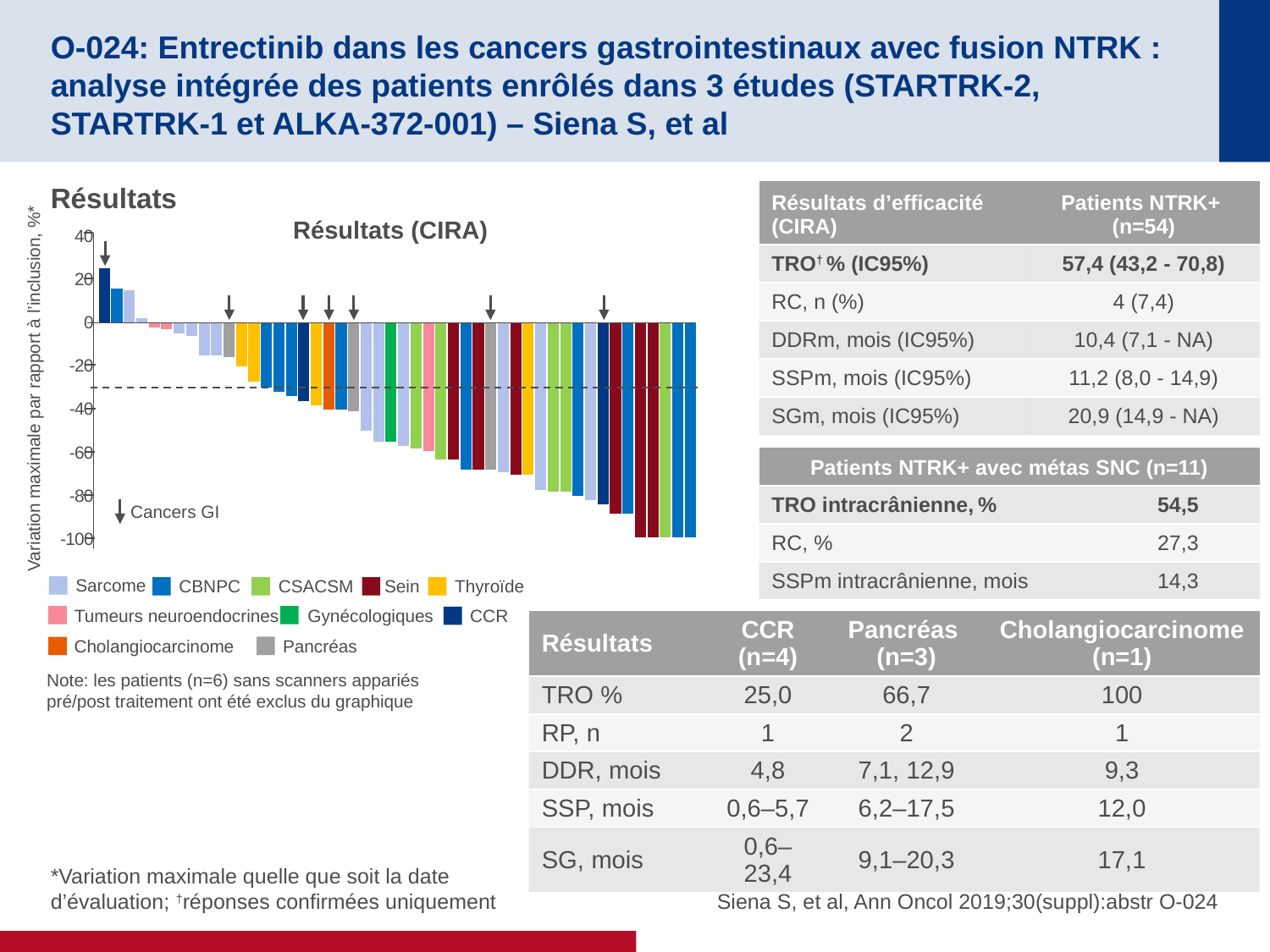
How many tumour types does the legend of the 'Résultats (CIRA)' chart list? 10 In the 'Résultats (CIRA)' chart, is the value of the leftmost bar greater or less than 0? greater In the 'Résultats (CIRA)' chart, is the value of the rightmost bar greater or less than -80? less In the 'Résultats (CIRA)' chart, is the value of the leftmost bar greater or less than 20? greater In the 'Résultats (CIRA)' chart, do the bar values rise or fall from left to right? fall What is the label of the vertical axis of the 'Résultats (CIRA)' chart? Variation maximale par rapport à l'inclusion, %* In the 'Résultats (CIRA)' chart, which tumour type (by legend colour) does the highest bar belong to? CCR What is the title of the bar chart on the slide? Résultats (CIRA) What kind of chart is shown under the heading 'Résultats (CIRA)'? bar chart